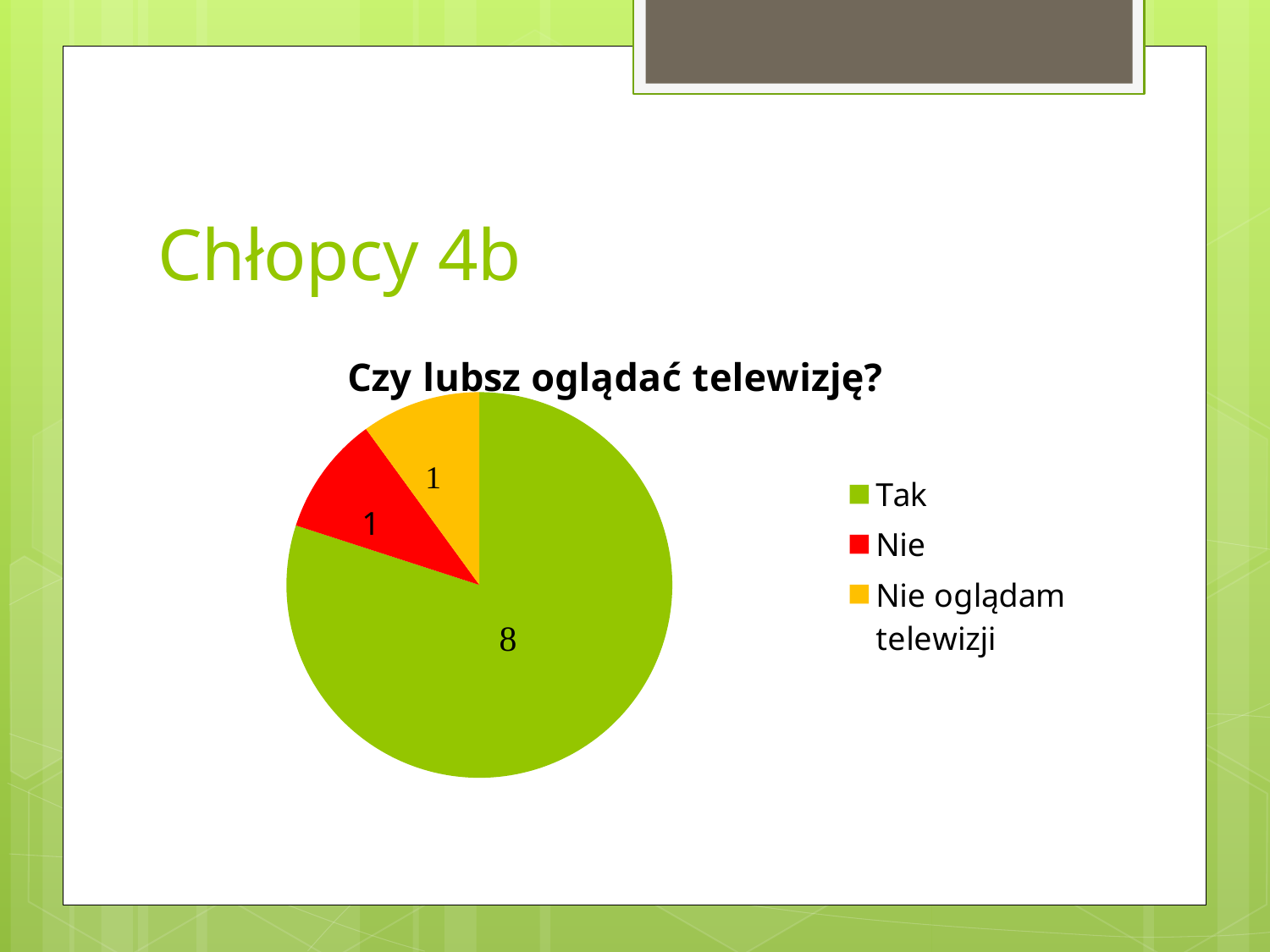
Which is larger, the "Tak" slice or the "Nie oglądam telewizji" slice? Tak What type of chart is shown on the slide? pie chart Which category has the largest slice? Tak How many categories does the legend list? 3 What is the value for the "Nie" slice? 1 What is the title of the chart? Czy lubsz oglądać telewizję? What is the difference between the "Tak" value and the "Nie" value? 7 What is the value for the "Tak" slice? 8 What share of the pie does the "Tak" slice represent? 80% What is the value for the "Nie oglądam telewizji" slice? 1 What colour is the "Nie" slice? red What is the total of all slices in the pie chart? 10